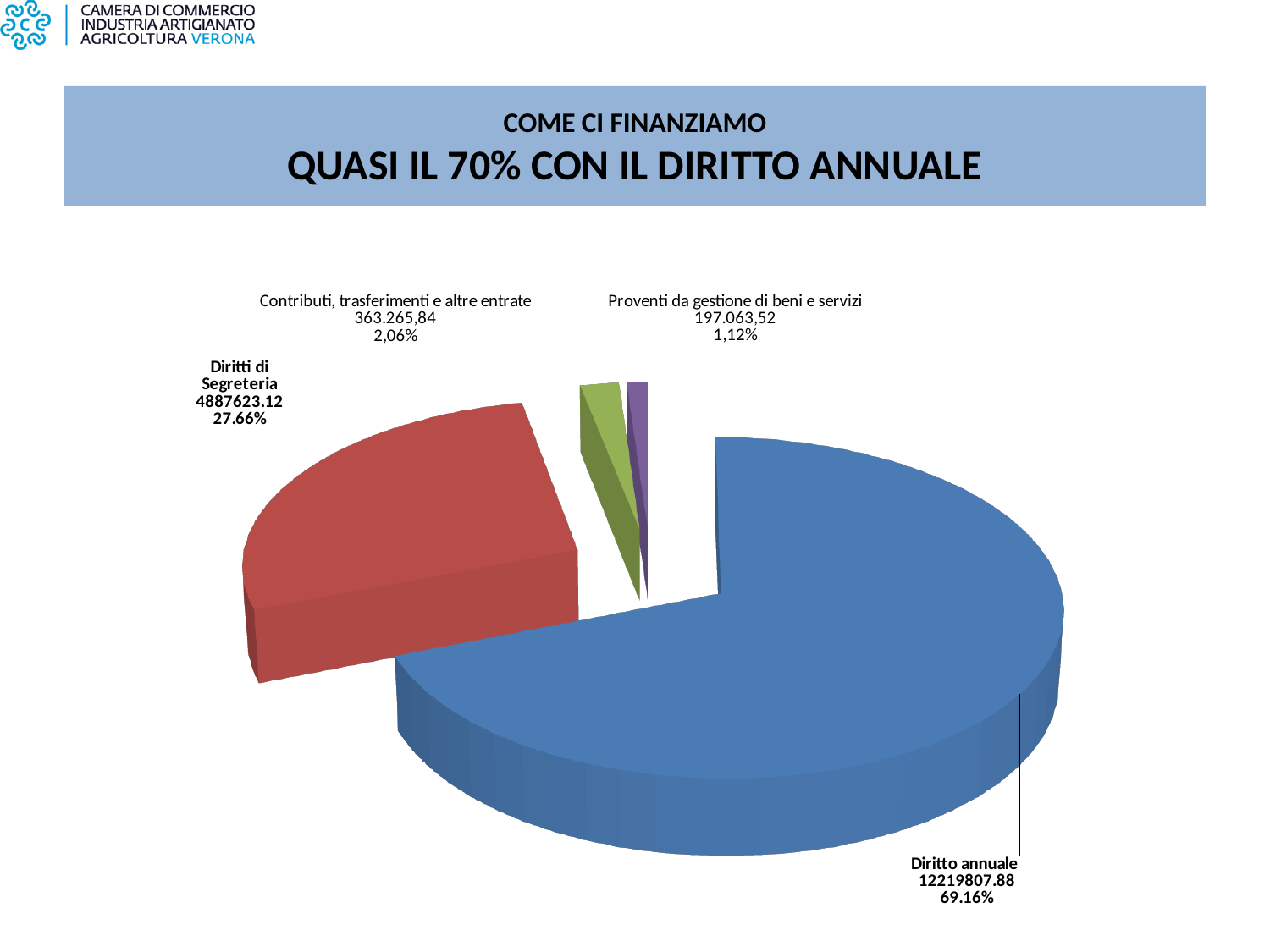
What colour is the Diritto annuale slice? Blue Which category has the smallest slice of the pie? Proventi da gestione di beni e servizi How many slices does the pie chart have? 4 What is the value shown for Contributi, trasferimenti e altre entrate? 363.265,84 What kind of chart is shown on the slide? Pie chart What share of the pie does Diritto annuale represent? 69.16% Which category has the largest slice of the pie? Diritto annuale What share of the pie does Diritti di Segreteria represent? 27.66% What is the value shown for Proventi da gestione di beni e servizi? 197.063,52 What is the value shown for Diritti di Segreteria? 4887623.12 What is the value shown for Diritto annuale? 12219807.88 Which is larger: the share for Contributi, trasferimenti e altre entrate or the share for Proventi da gestione di beni e servizi? Contributi, trasferimenti e altre entrate